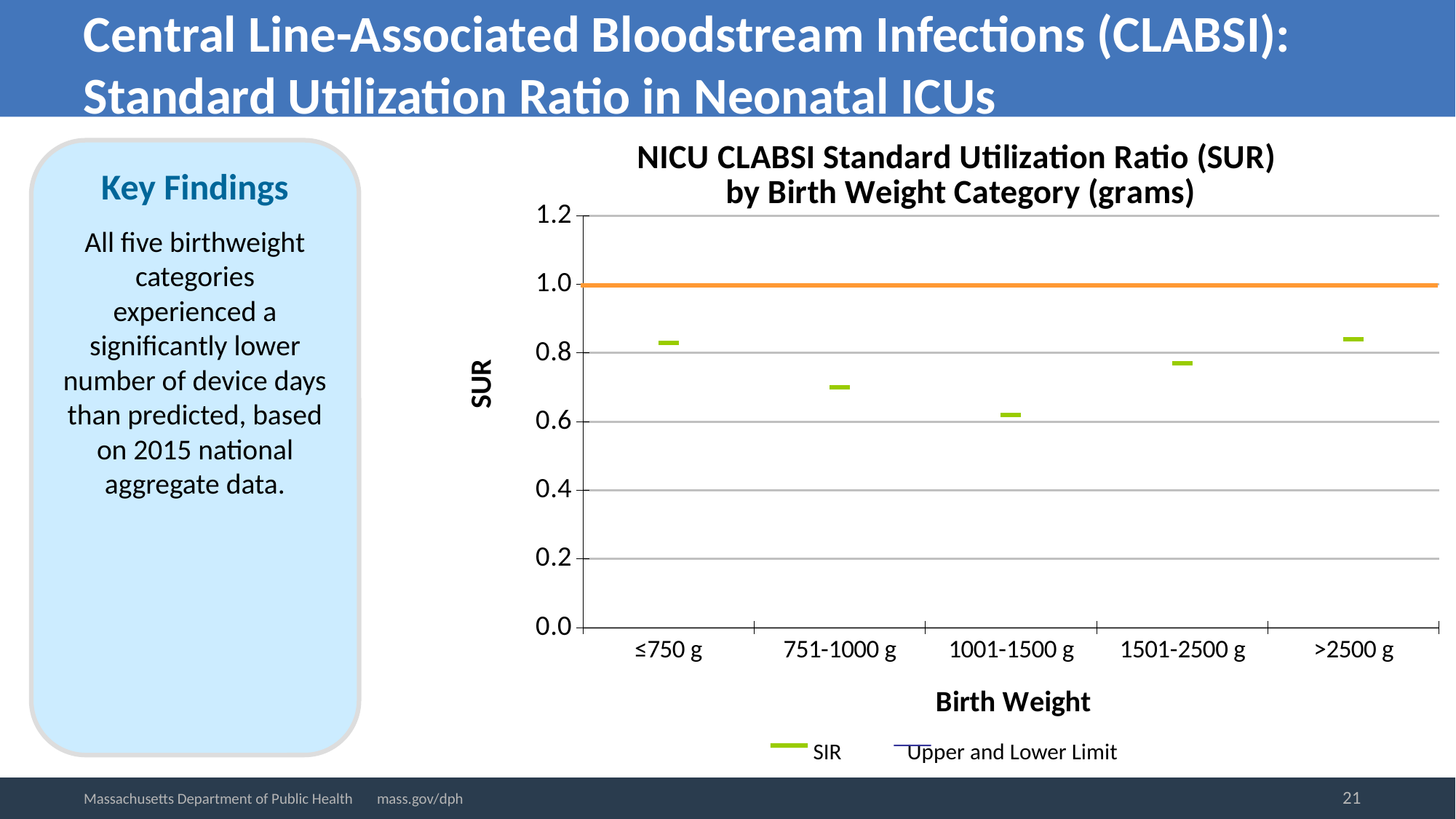
Is the SIR value for 751-1000 g greater or less than 0.8? less How many series does the legend list? 2 Which birth weight category has the lowest SIR value? 1001-1500 g Is the SIR value for 1501-2500 g greater or less than 0.6? greater Which has a higher SIR value, 751-1000 g or 1001-1500 g? 751-1000 g At what SUR value is the orange Upper and Lower Limit line drawn? 1.0 What is the title of the y axis? SUR Is the SIR value for ≤750 g greater or less than 0.8? greater Which has a higher SIR value, ≤750 g or 1501-2500 g? ≤750 g How many birth weight categories are shown on the x axis? 5